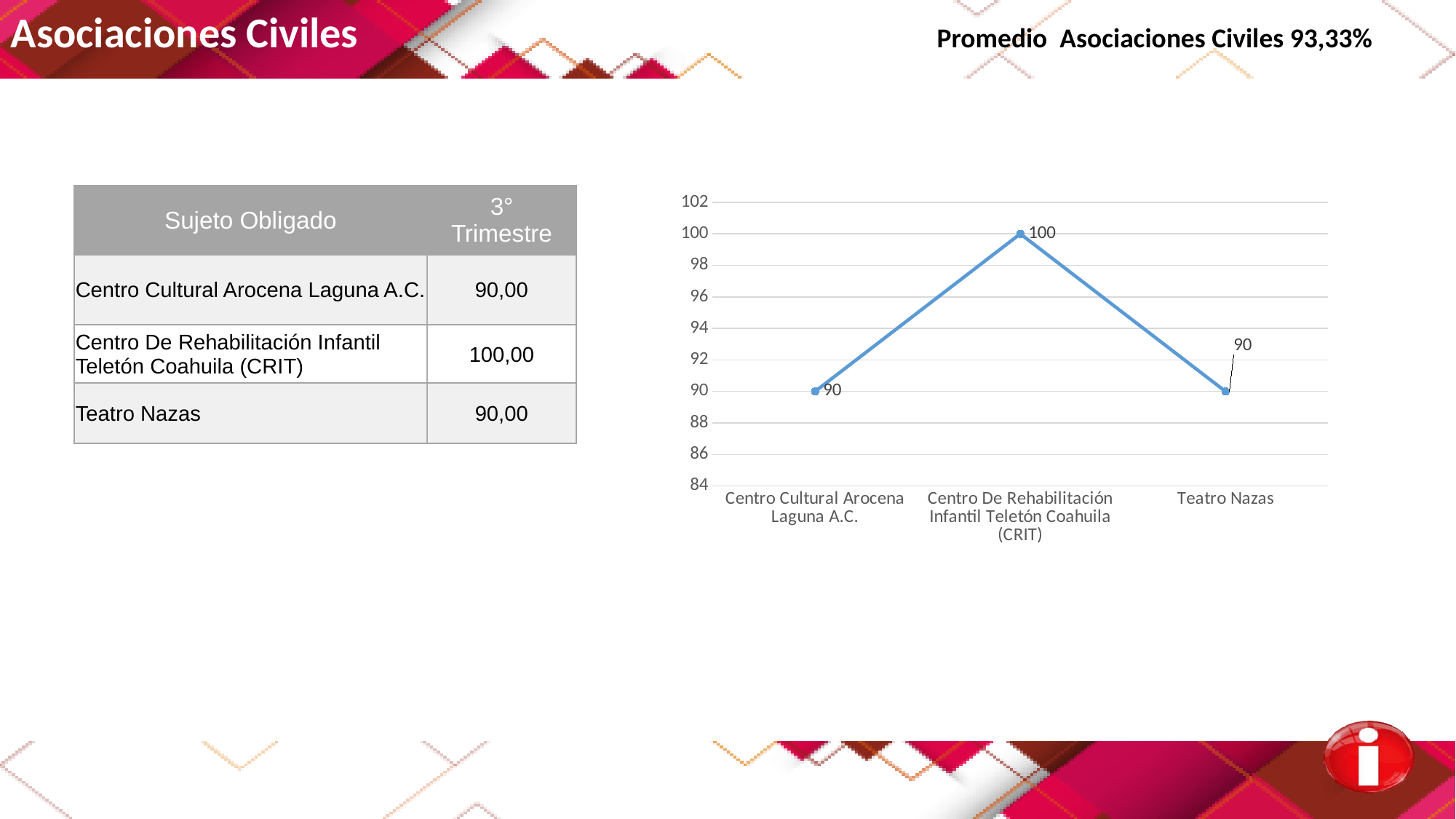
What is the value plotted for Centro Cultural Arocena Laguna A.C.? 90 What is the value plotted for Teatro Nazas? 90 What type of chart is shown on the slide? line chart What is the difference between the value for Centro De Rehabilitación Infantil Teletón Coahuila (CRIT) and the value for Teatro Nazas? 10 What is the highest value shown on the chart's vertical axis? 102 Does the line rise or fall from Centro De Rehabilitación Infantil Teletón Coahuila (CRIT) to Teatro Nazas? fall What is the lowest value shown on the chart's vertical axis? 84 Which category has the highest value in the chart? Centro De Rehabilitación Infantil Teletón Coahuila (CRIT) Which is larger: the value for Centro De Rehabilitación Infantil Teletón Coahuila (CRIT) or the value for Centro Cultural Arocena Laguna A.C.? Centro De Rehabilitación Infantil Teletón Coahuila (CRIT) How many categories are plotted on the x axis of the chart? 3 Is the value for Teatro Nazas greater or less than 96? less What is the value plotted for Centro De Rehabilitación Infantil Teletón Coahuila (CRIT)? 100